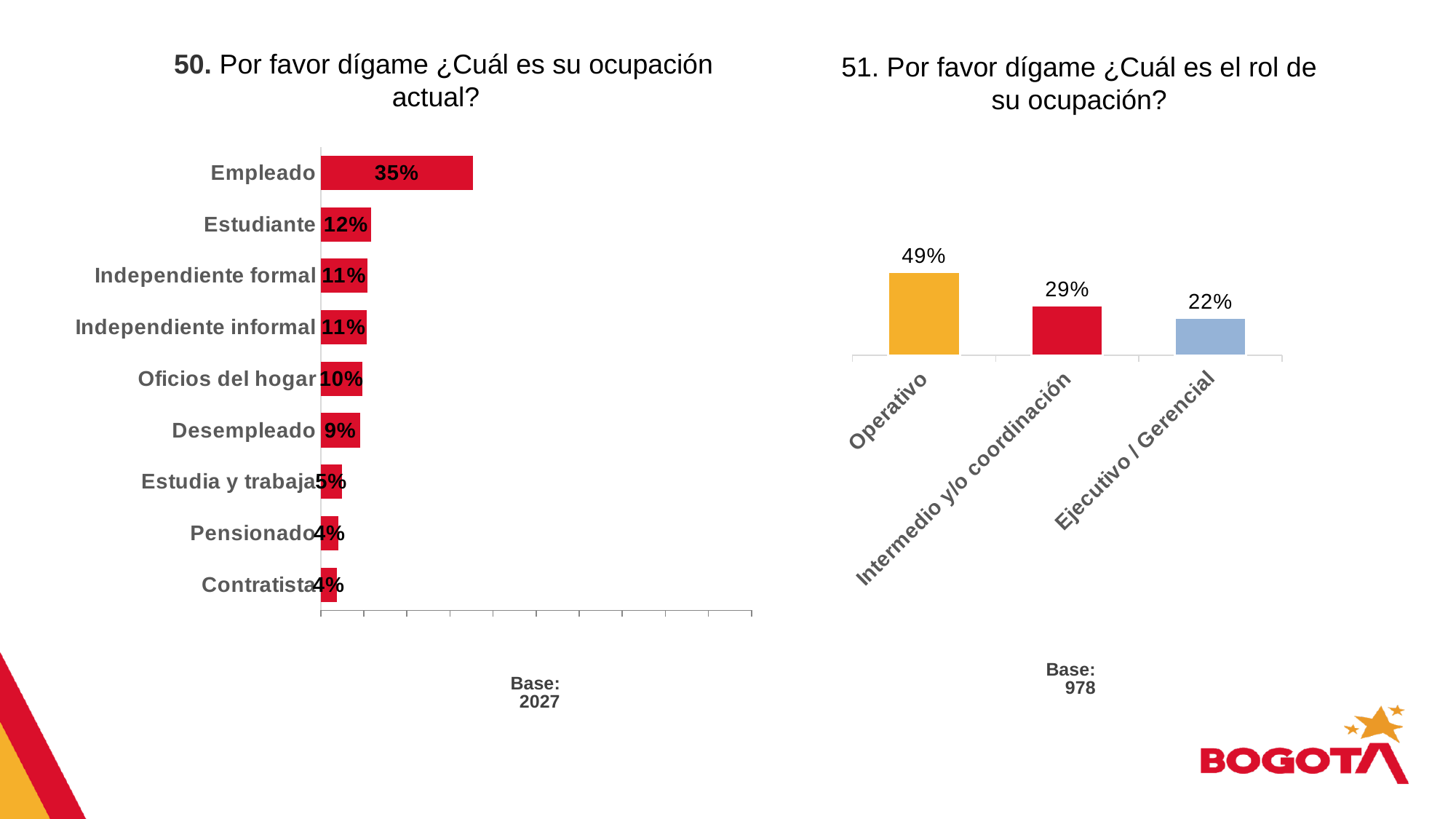
In the right chart (question 51, rol de su ocupación), what colour is the bar for Operativo? Yellow/orange In the right chart (question 51, rol de su ocupación), what is the difference between Operativo and Intermedio y/o coordinación? 20% In the left chart (question 50, ocupación actual), which is larger, Desempleado or Estudia y trabaja? Desempleado In the left chart (question 50, ocupación actual), how many categories are shown? 9 In the left chart (question 50, ocupación actual), which category has the highest value? Empleado In the right chart (question 51, rol de su ocupación), how many categories are shown? 3 In the left chart (question 50, ocupación actual), what is the difference between Empleado and Estudiante? 23% In the left chart (question 50, ocupación actual), what is the value for Empleado? 35% In the left chart (question 50, ocupación actual), what kind of chart is it? Bar chart In the right chart (question 51, rol de su ocupación), which category has the lowest value? Ejecutivo / Gerencial In the right chart (question 51, rol de su ocupación), what is the value for Operativo? 49% In the left chart (question 50, ocupación actual), what is the value for Oficios del hogar? 10%